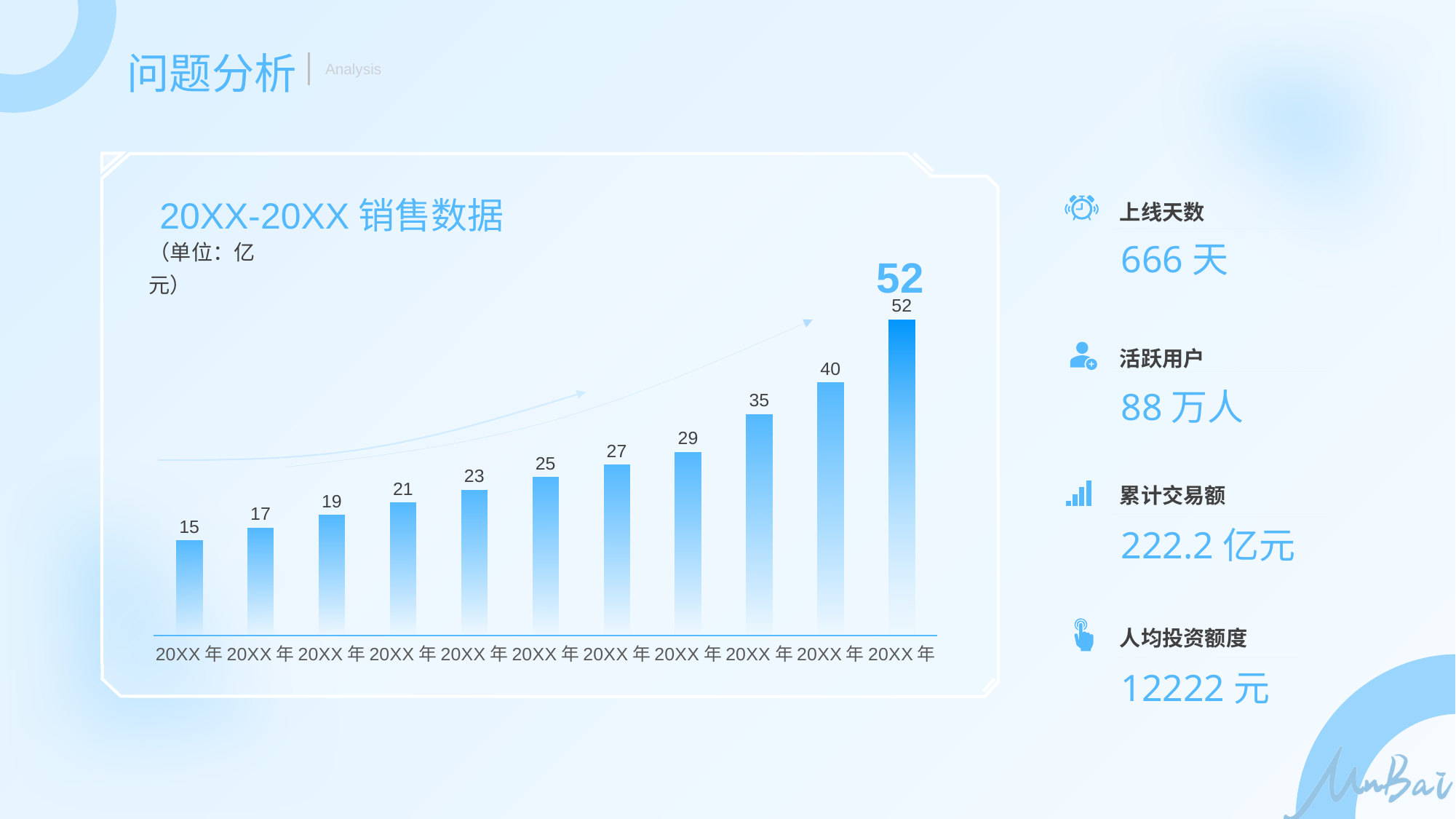
What type of chart is shown on the slide? bar chart How many bars are plotted in the chart? 11 What is the highest value shown in the chart? 52 What is the value of the third bar from the left? 19 What is the value of the rightmost bar in the chart? 52 Do the values rise or fall from left to right along the x axis? rise What is the value of the leftmost bar in the chart? 15 What unit is stated for the chart's values? 亿元 Which is larger, the value of the ninth bar from the left or the value of the eighth bar from the left? the ninth bar (35) What is the value of the second bar from the right? 40 What is the lowest value shown in the chart? 15 What is the difference between the rightmost bar and the leftmost bar? 37